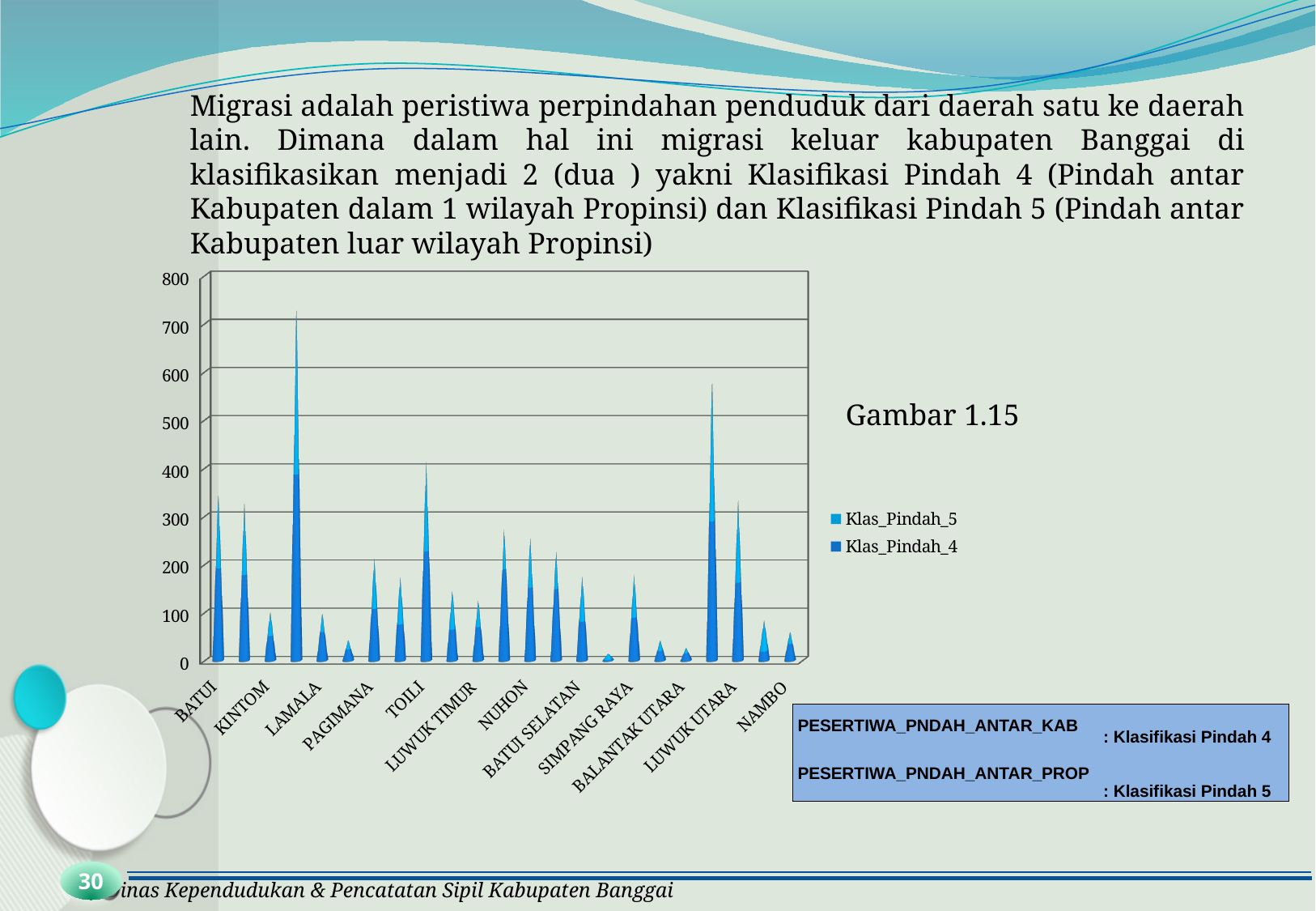
Is the total value for NAMBO greater or less than 100? less What figure label is shown next to the chart? Gambar 1.15 What kind of chart is shown on the slide? bar chart What are the two series named in the chart legend? Klas_Pindah_5 and Klas_Pindah_4 Is the total value for BATUI greater or less than 200? greater Which has the larger total value, BATUI or NAMBO? BATUI How many series does the chart legend list? 2 Is the total value for LUWUK UTARA greater or less than 200? greater What is the highest value shown on the chart's vertical axis? 800